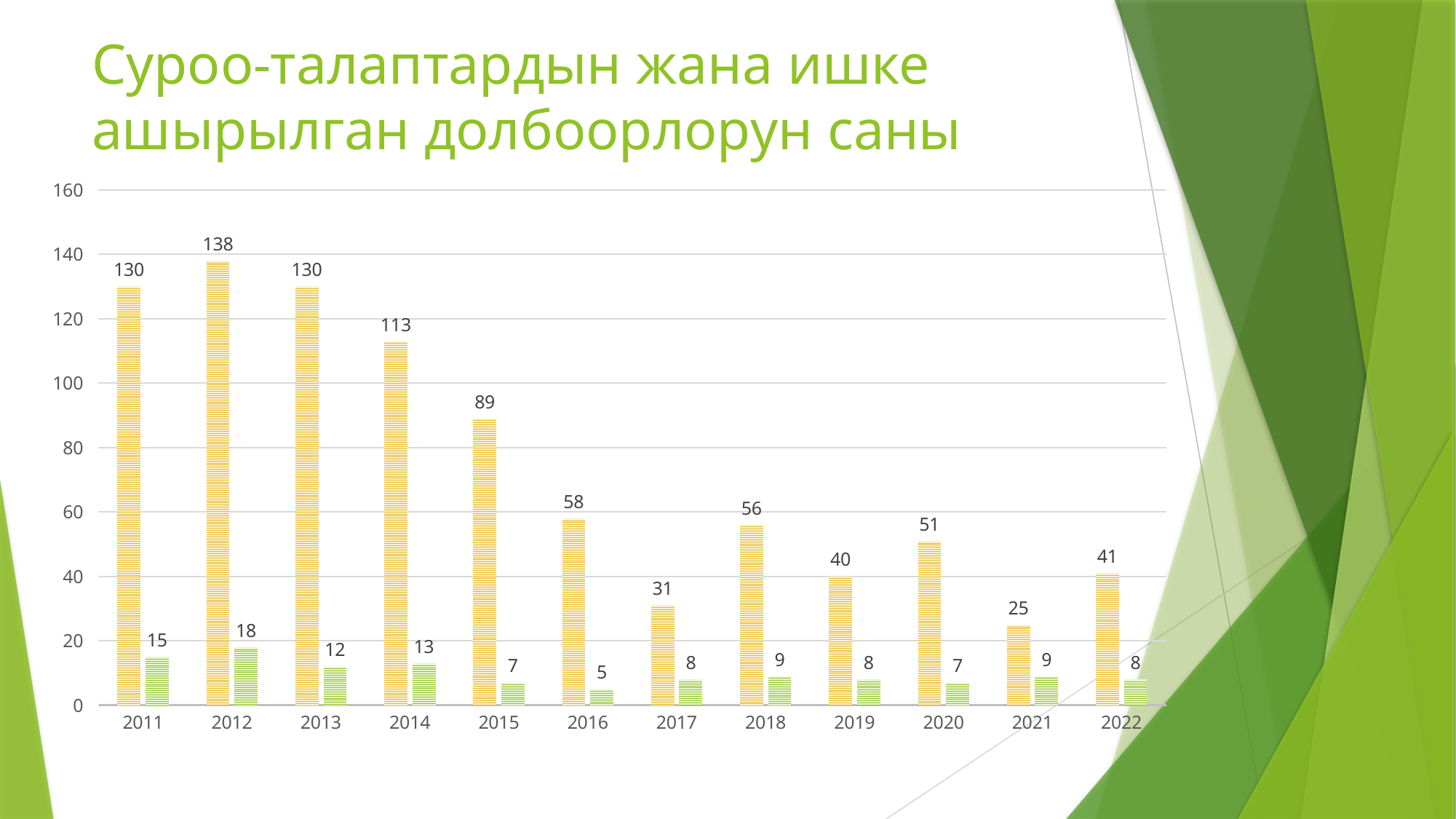
How many years are shown on the x axis? 12 Do the orange bar values generally rise or fall from 2011 to 2022? Fall Which year has the highest orange bar? 2012 Which year has the lowest orange bar? 2021 What is the value of the orange bar for 2012? 138 Which year has the lowest green bar? 2016 Which is larger, the orange bar for 2018 or the orange bar for 2020? 2018 What is the difference between the green bar values for 2012 and 2015? 11 What is the value of the green bar for 2014? 13 What kind of chart is shown on the slide? Bar chart What is the difference between the orange bar values for 2011 and 2022? 89 What is the value of the orange bar for 2019? 40